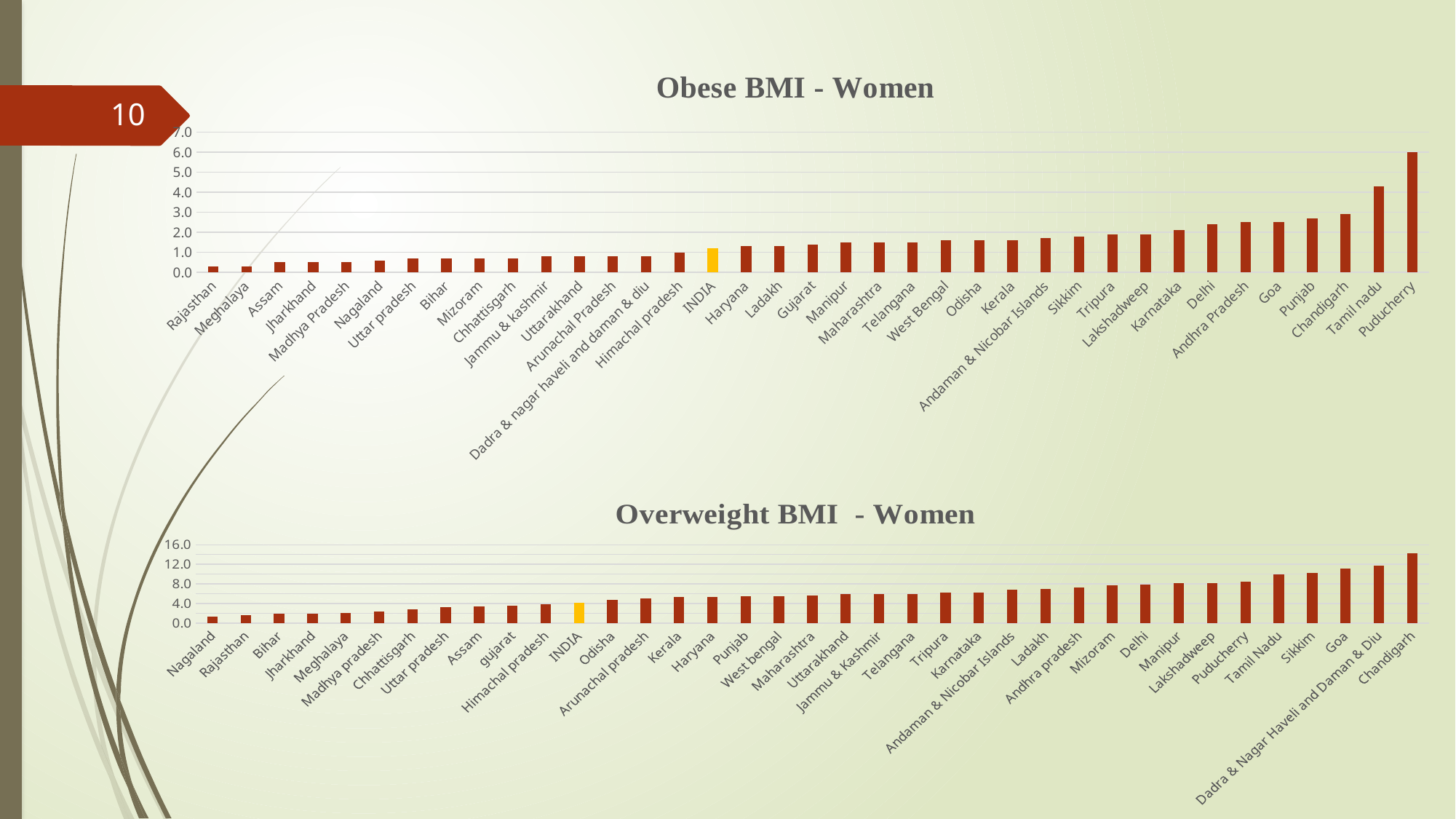
In the 'Overweight BMI - Women' chart, which state or territory has the highest value? Chandigarh In the 'Overweight BMI - Women' chart, is the value for Chandigarh greater or less than 12.0? greater In the 'Overweight BMI - Women' chart, which category has the lowest value? Nagaland What kind of chart is the 'Overweight BMI - Women' chart? bar chart In the 'Obese BMI - Women' chart, is the value for Tamil nadu greater or less than 4.0? greater In the 'Obese BMI - Women' chart, is the value for INDIA greater or less than 2.0? less In the 'Obese BMI - Women' chart, which has the larger value, Puducherry or Chandigarh? Puducherry In the 'Obese BMI - Women' chart, do the values rise or fall from left to right along the x axis? rise In the 'Obese BMI - Women' chart, which category is highlighted with a yellow bar? INDIA In the 'Obese BMI - Women' chart, which state or territory has the highest value? Puducherry In the 'Obese BMI - Women' chart, which category has the lowest value? Rajasthan and Meghalaya (tied)